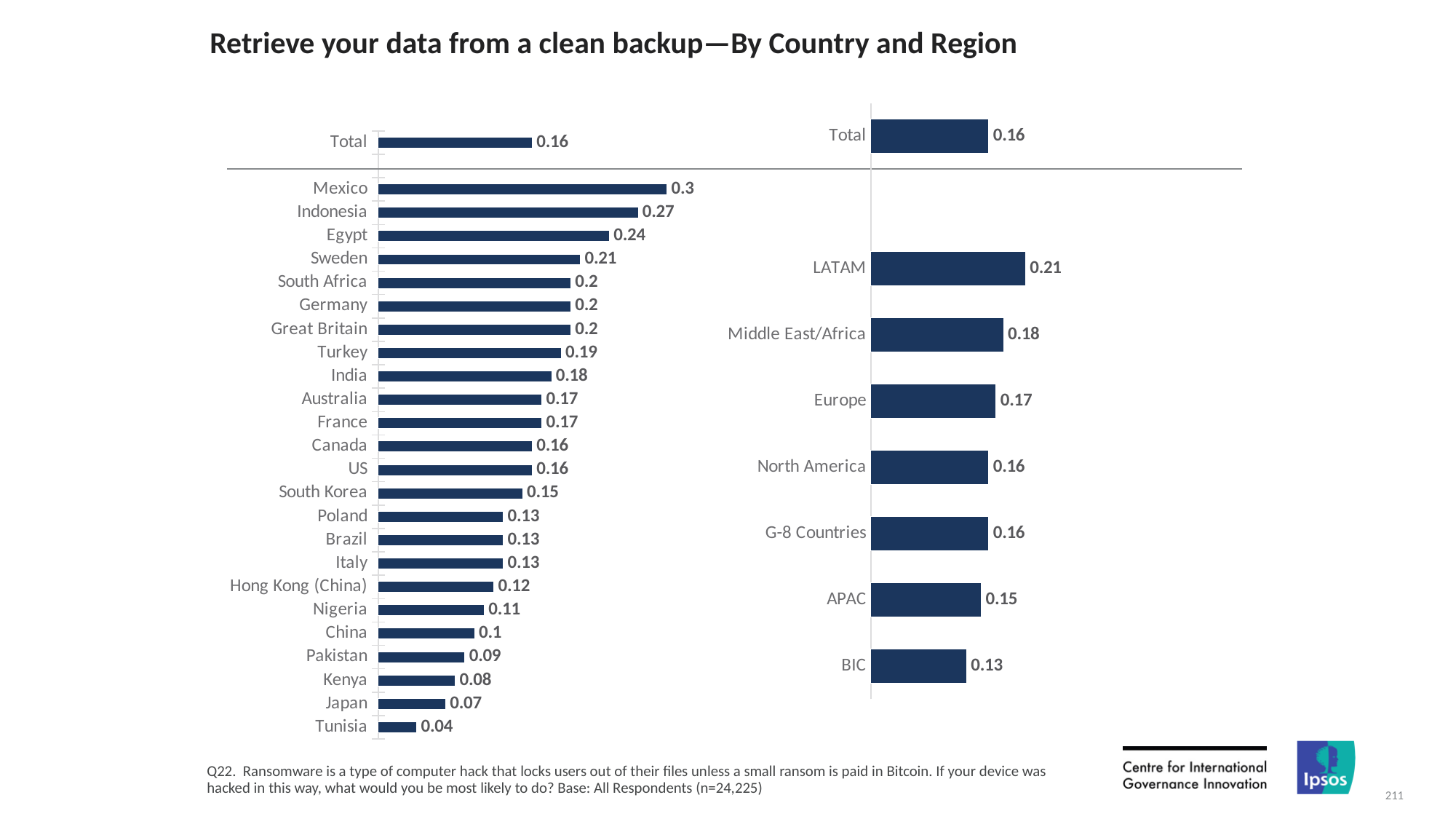
In the left-hand chart (by country), what is the difference between the values for Indonesia and Egypt? 0.03 In the left-hand chart (by country), which has the larger value, Sweden or Turkey? Sweden In the left-hand chart (by country), how many countries are listed below the Total bar? 24 In the right-hand chart (by region), which region has the lowest value? BIC In the left-hand chart (by country), what is the value for Japan? 0.07 In the left-hand chart (by country), what is the value for Mexico? 0.3 In the right-hand chart (by region), what is the value for LATAM? 0.21 In the left-hand chart (by country), which country has the lowest value? Tunisia In the left-hand chart (by country), which country has the highest value? Mexico In the right-hand chart (by region), what is the difference between the values for Middle East/Africa and APAC? 0.03 What kind of chart is the right-hand chart (by region)? Bar chart In the right-hand chart (by region), how many regions are listed below the Total bar? 7